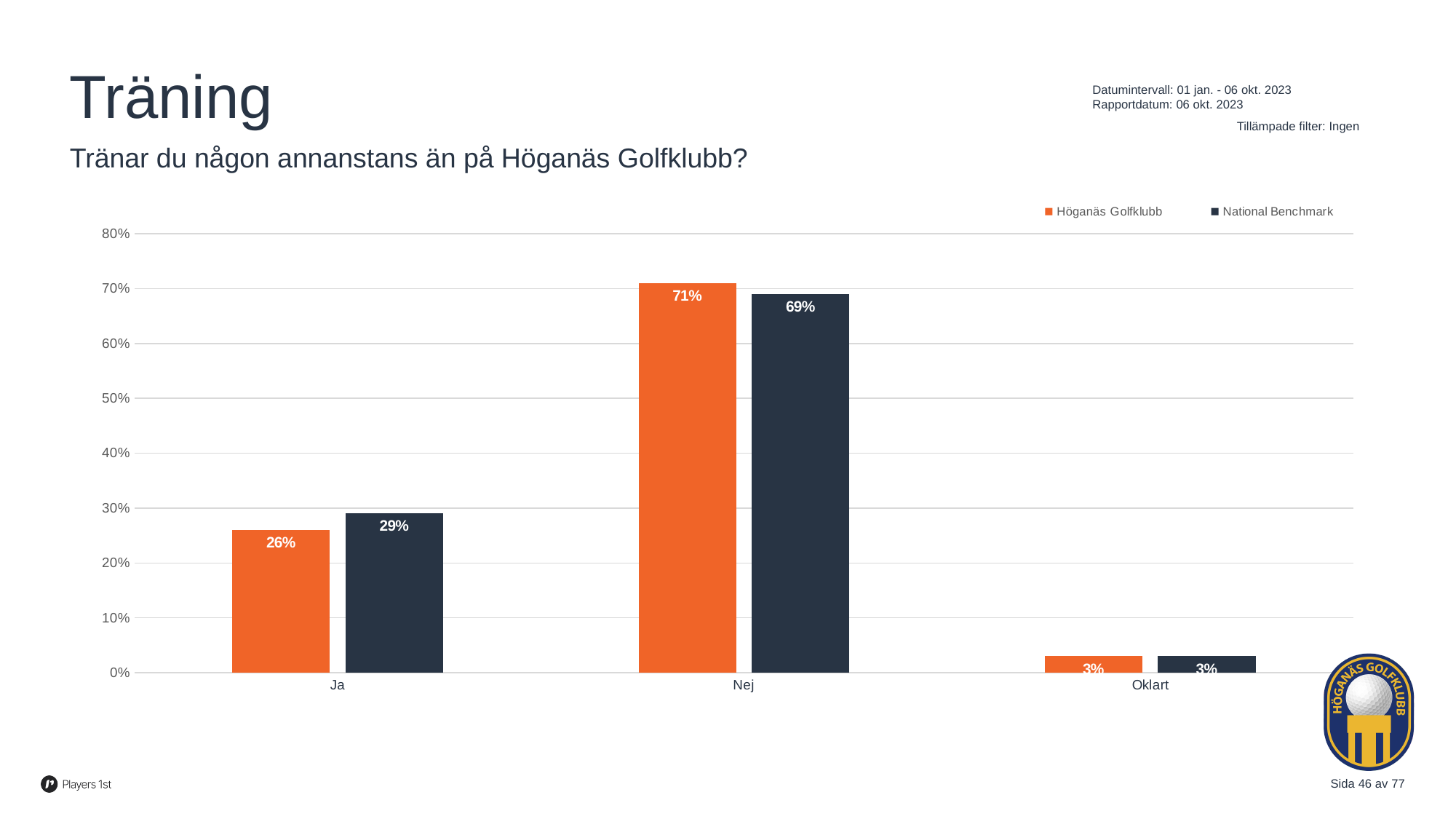
What is the value for Höganäs Golfklubb in the Ja category? 26% Which series is shown in orange? Höganäs Golfklubb Is the value for Höganäs Golfklubb in the Nej category greater or less than 60%? greater What is the value for National Benchmark in the Nej category? 69% Which category has the highest value for Höganäs Golfklubb? Nej What is the difference between the Höganäs Golfklubb and National Benchmark values in the Nej category? 2% What kind of chart is shown on the slide? bar chart How many series does the legend list? 2 How many categories are shown on the x axis? 3 What is the value for Höganäs Golfklubb in the Oklart category? 3% In the Ja category, which is larger: Höganäs Golfklubb or National Benchmark? National Benchmark Which category has the lowest value for National Benchmark? Oklart